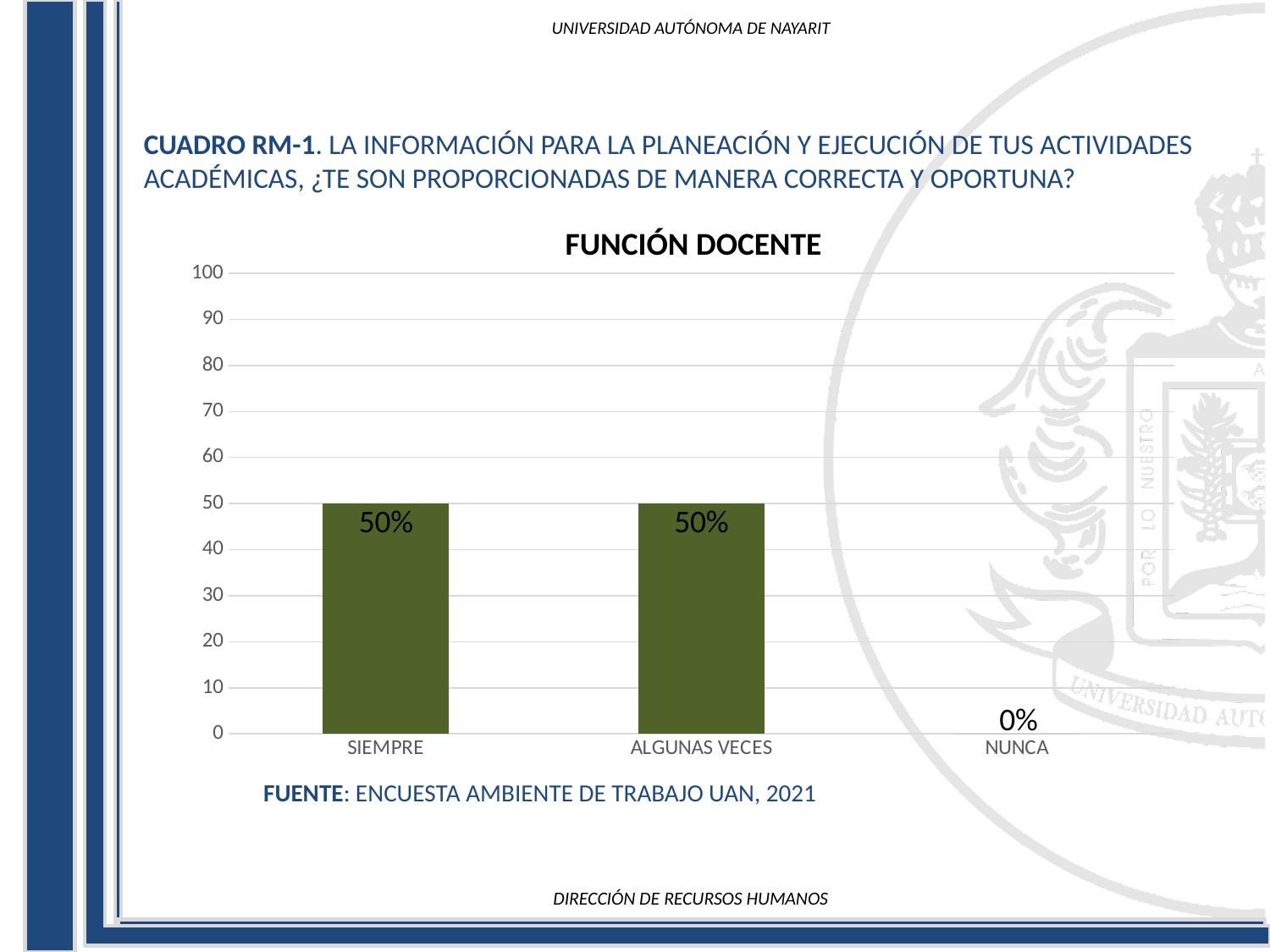
What is the value for NUNCA? 0% What is the highest value shown on the y axis? 100 Is the value for SIEMPRE greater or less than 60? less Is the value for ALGUNAS VECES greater or less than 40? greater What kind of chart is shown on the slide? bar chart What is the value for SIEMPRE? 50% Which category has the lowest value? NUNCA What is the difference between the values for SIEMPRE and NUNCA? 50% How many categories are shown on the x axis? 3 What is the title of the chart? FUNCIÓN DOCENTE What is the value for ALGUNAS VECES? 50% Which is larger, the value for ALGUNAS VECES or the value for NUNCA? ALGUNAS VECES